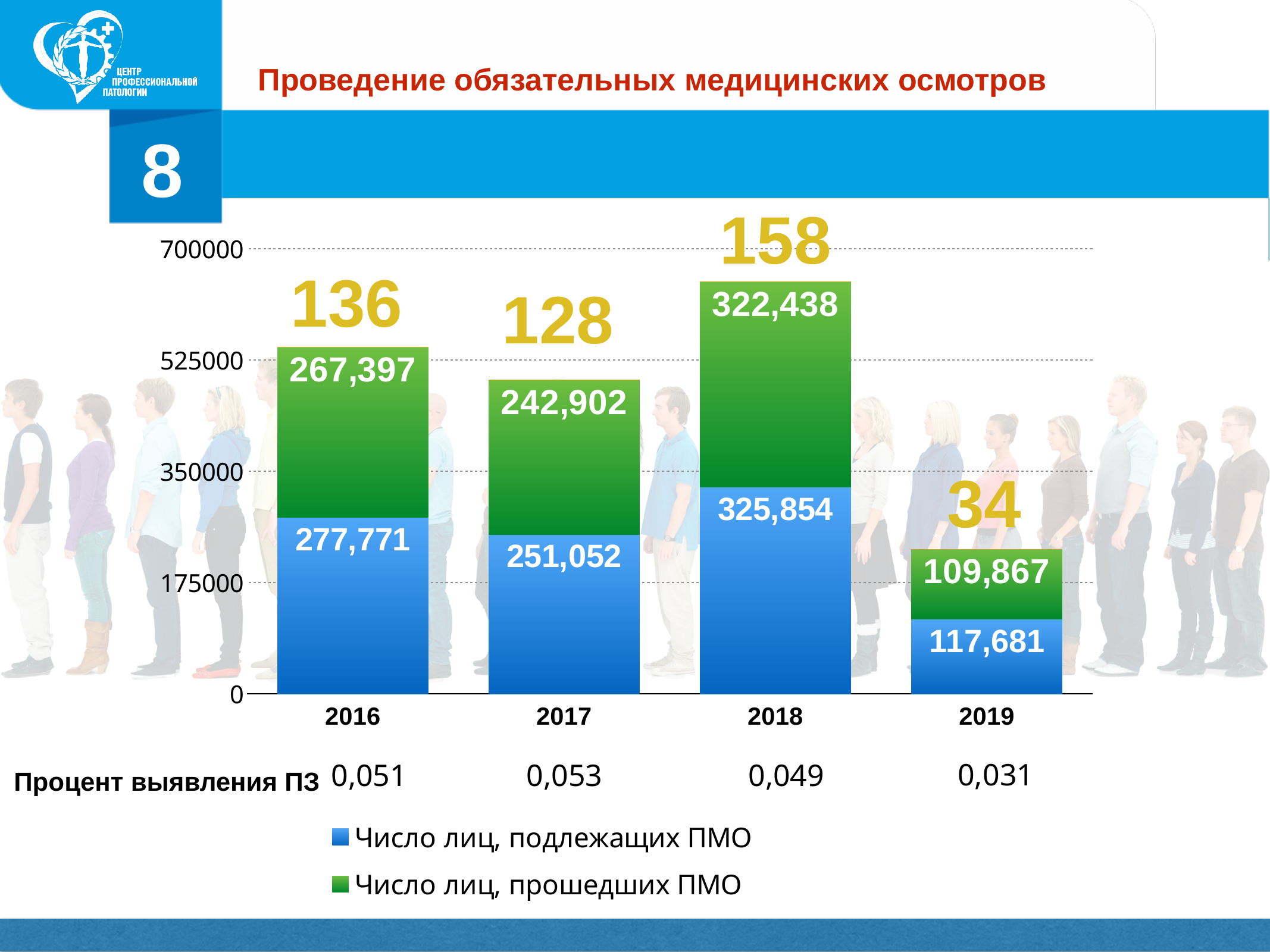
Which year has the lowest value for "Число лиц, прошедших ПМО"? 2019 What is the value of "Число лиц, прошедших ПМО" for 2017? 242,902 How many years are shown on the x axis? 4 What is the total of the stacked bar for 2018? 648,292 Which year has the highest value for "Число лиц, подлежащих ПМО"? 2018 What is the value of "Число лиц, прошедших ПМО" for 2019? 109,867 Which is larger: "Число лиц, подлежащих ПМО" in 2017 or in 2018? 2018 What is the difference between "Число лиц, подлежащих ПМО" and "Число лиц, прошедших ПМО" in 2016? 10,374 Is the total height of the stacked bar for 2019 greater or less than 350000? less How many series does the legend list? 2 What kind of chart is shown on the slide? stacked bar chart What is the value of "Число лиц, подлежащих ПМО" for 2018? 325,854